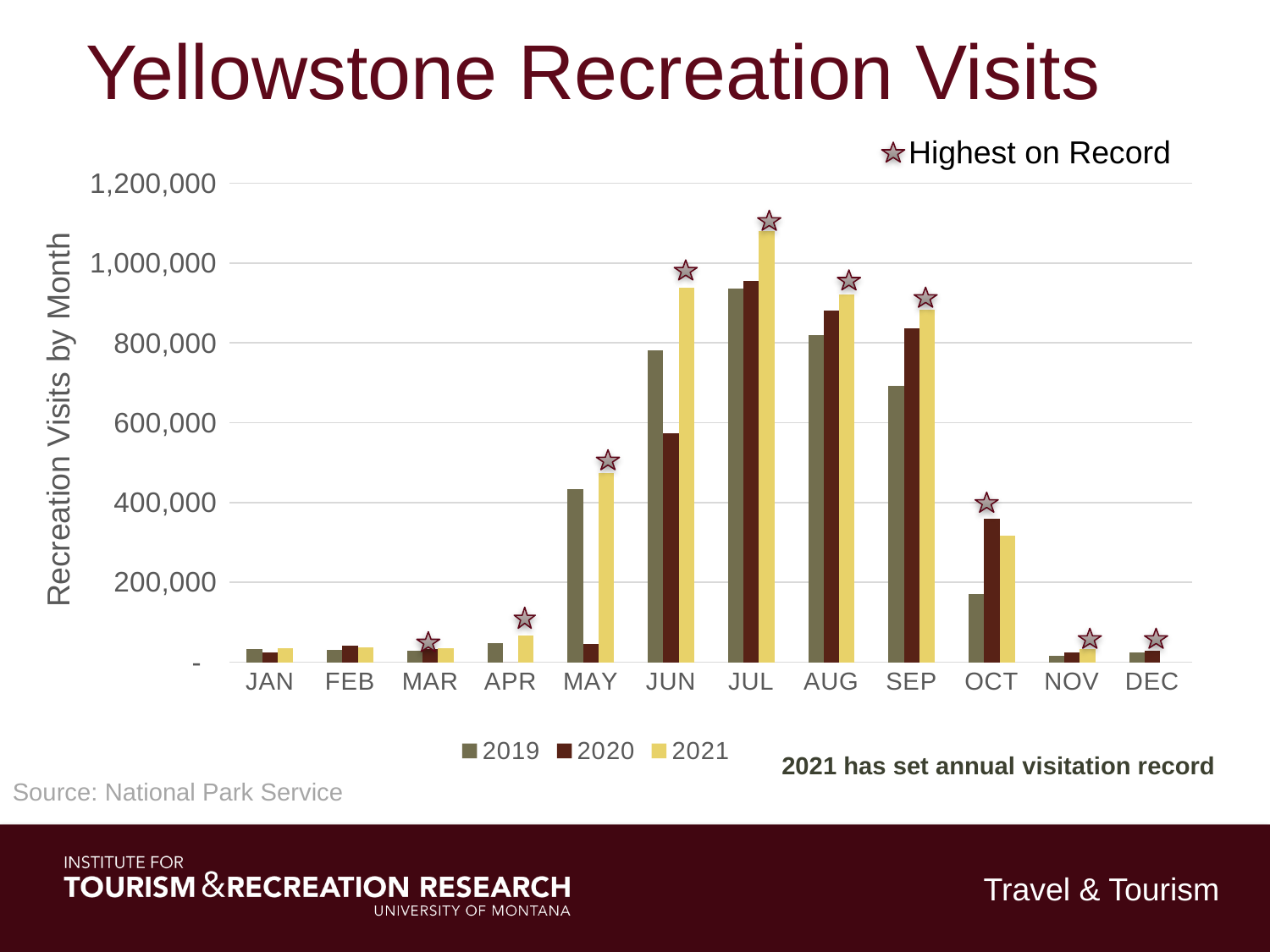
How many months are shown on the x axis? 12 Is the 2021 value for AUG greater or less than 800,000? greater Is the 2020 value for JUN greater or less than 600,000? less In OCT, which is larger: the 2020 value or the 2021 value? 2020 Which series has the lowest value in JUN? 2020 What kind of chart is shown on the slide? bar chart What does the star symbol above a bar indicate? Highest on Record Which month has the highest 2021 value? JUL Is the 2021 value for JUL greater or less than 1,000,000? greater In JUN, which is larger: the 2019 value or the 2020 value? 2019 How many series does the legend list? 3